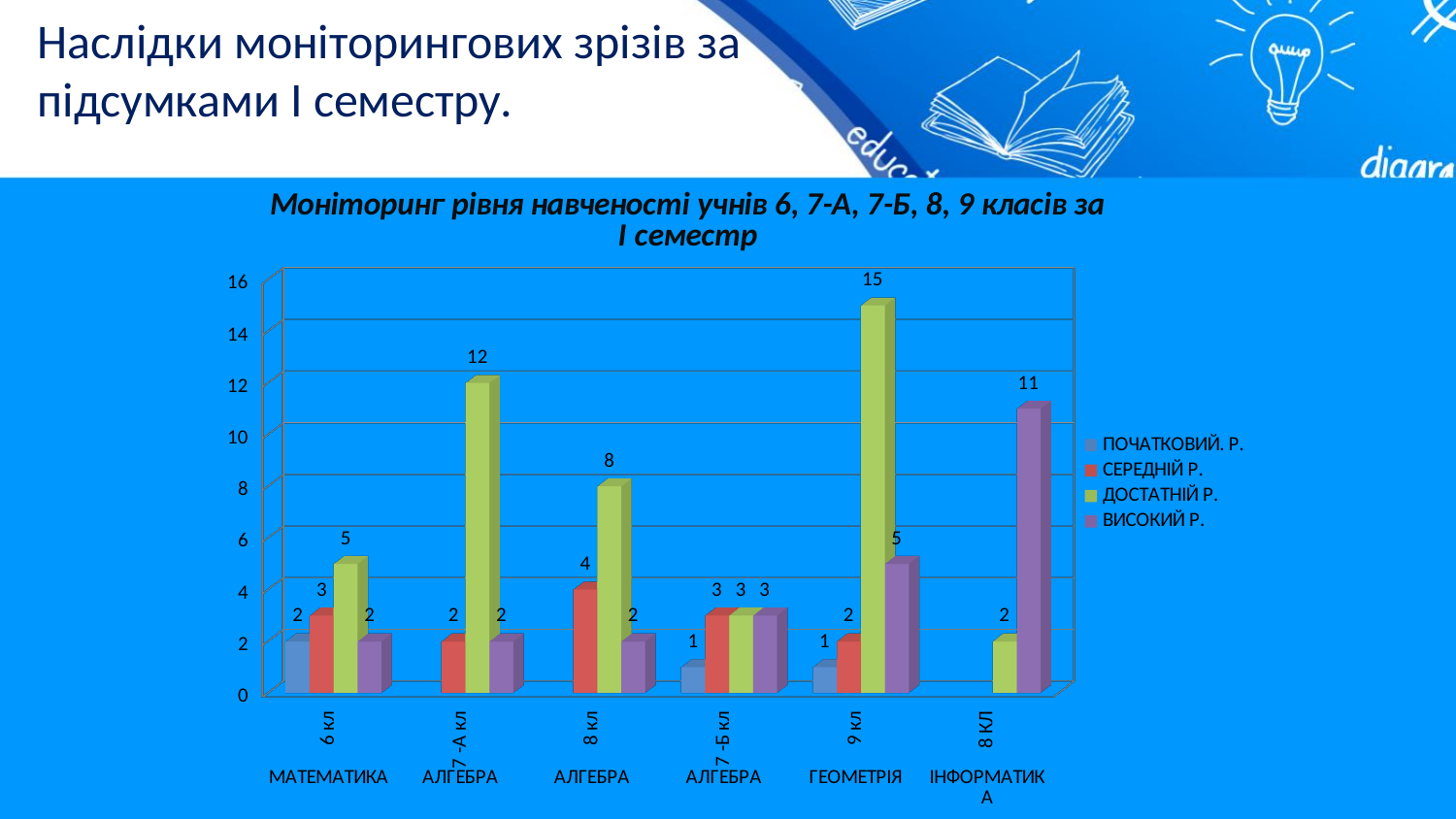
How many subject/class categories are shown along the x axis? 6 What is the value of ВИСОКИЙ Р. for ІНФОРМАТИКА 8 кл? 11 Which is larger: the ВИСОКИЙ Р. value for ГЕОМЕТРІЯ 9 кл or for ІНФОРМАТИКА 8 кл? ІНФОРМАТИКА 8 кл What kind of chart is shown on the slide? bar chart What is the value of СЕРЕДНІЙ Р. for АЛГЕБРА 8 кл? 4 What is the difference between the ДОСТАТНІЙ Р. values for ГЕОМЕТРІЯ 9 кл and АЛГЕБРА 7-А кл? 3 What is the value of ДОСТАТНІЙ Р. for ГЕОМЕТРІЯ 9 кл? 15 What is the value of ПОЧАТКОВИЙ Р. for АЛГЕБРА 7-Б кл? 1 Which category has the highest value for ВИСОКИЙ Р.? ІНФОРМАТИКА 8 кл Which category has the highest value for ДОСТАТНІЙ Р.? ГЕОМЕТРІЯ 9 кл What is the value of ДОСТАТНІЙ Р. for АЛГЕБРА 7-А кл? 12 How many series does the legend list? 4